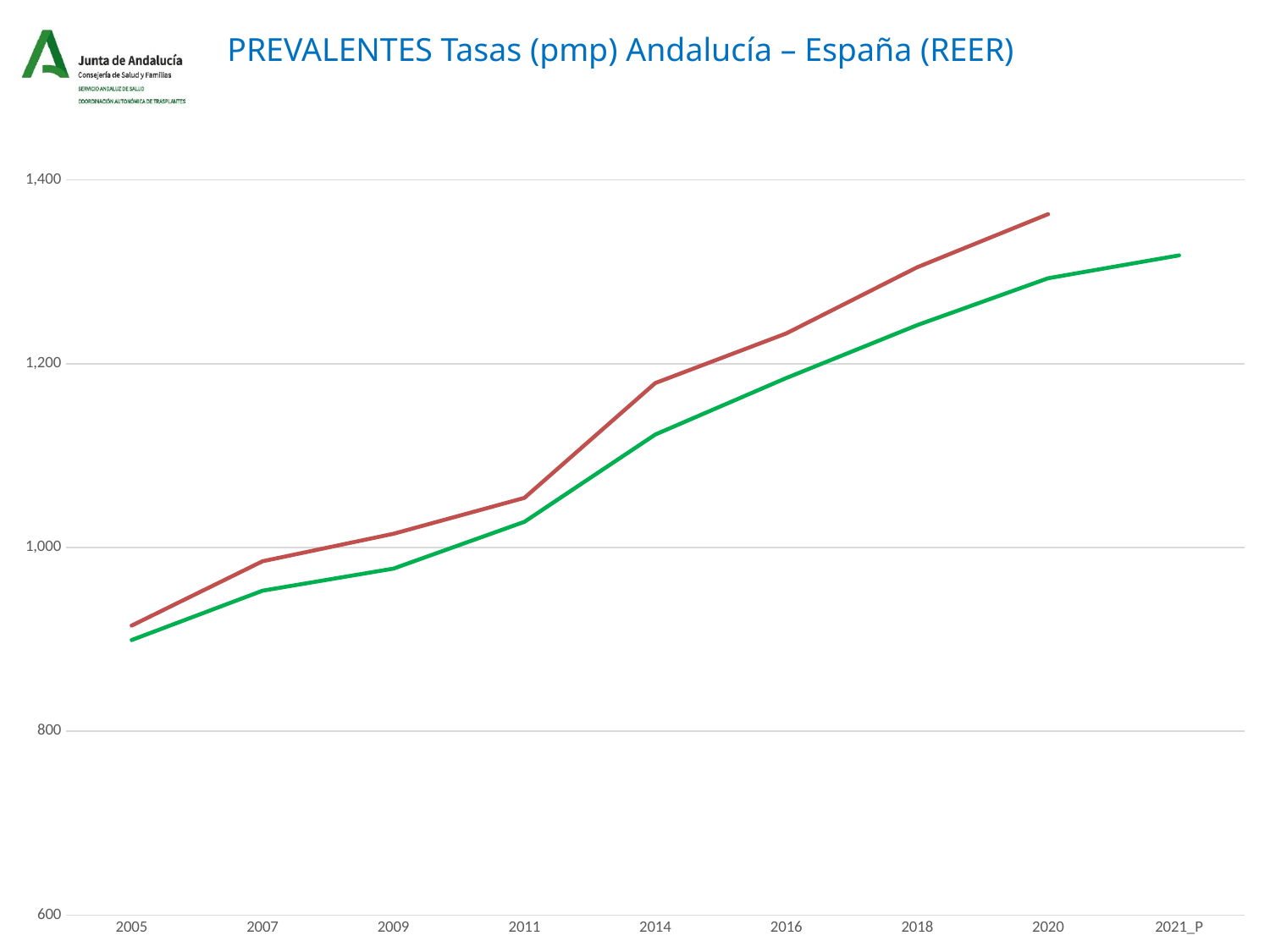
Is the value of the green line in 2021_P greater or less than 1,200? greater How many year categories are shown on the x axis? 9 What kind of chart is shown on the slide? line chart Is the value of the red line in 2005 greater or less than 1,000? less Is the value of the green line in 2011 greater or less than 1,000? greater Do the values of the red line rise or fall from 2005 to 2020? rise In which year does the red line reach its highest value? 2020 Do the values of the green line rise or fall from 2005 to 2021_P? rise What is the title of the chart? PREVALENTES Tasas (pmp) Andalucía – España (REER) In 2020, which line has the higher value, the red line or the green line? the red line